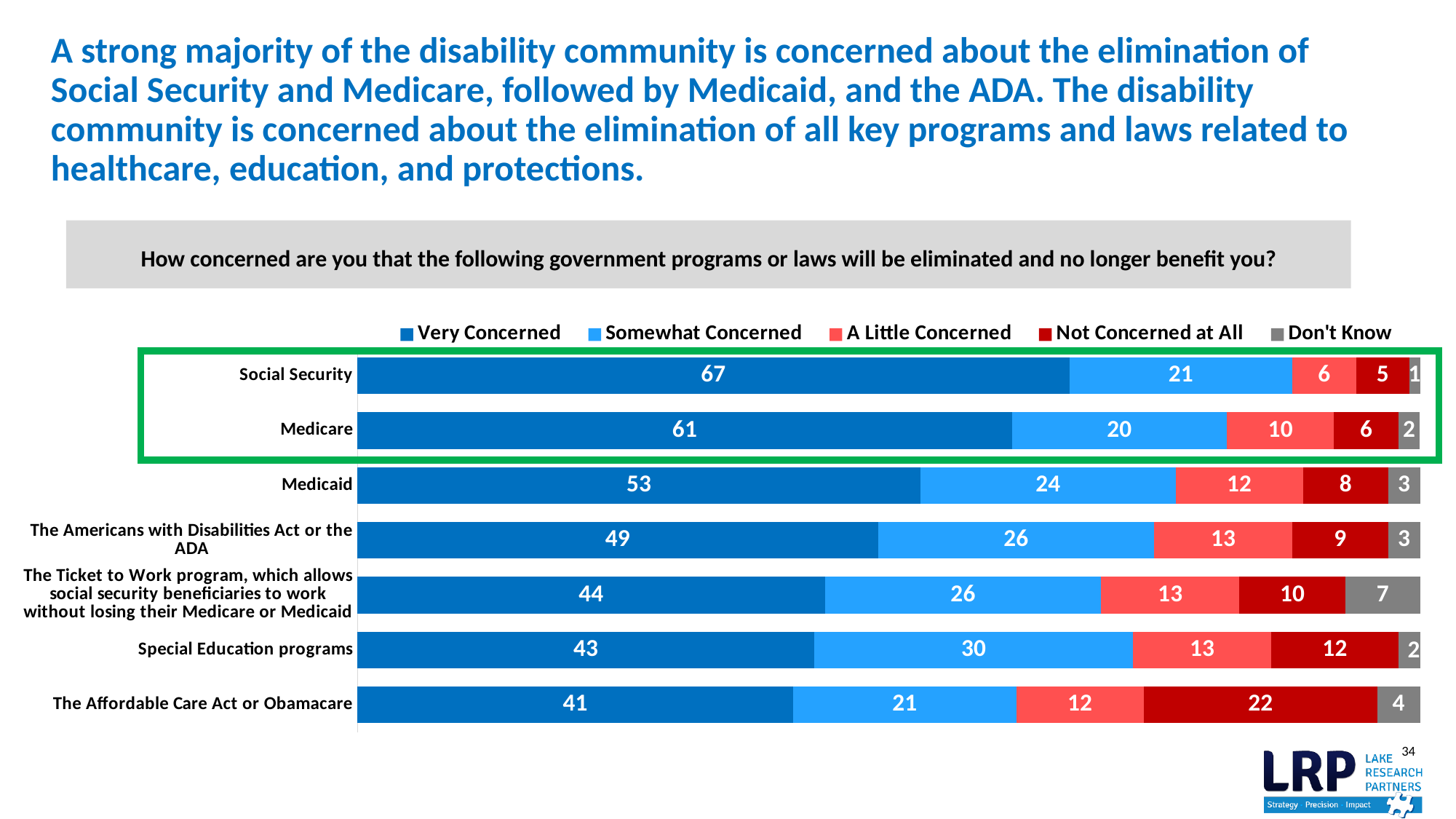
What is the 'Not Concerned at All' value for The Affordable Care Act or Obamacare? 22 What is the 'Very Concerned' value for Social Security? 67 What is the difference between the 'Very Concerned' values for Social Security and Medicare? 6 What is the 'Don't Know' value for The Ticket to Work program? 7 What is the 'Somewhat Concerned' value for Special Education programs? 30 What is the total of the stacked bar for Medicaid? 100 How many programs or laws are shown in the chart? 7 Which program has the lowest 'Very Concerned' value? The Affordable Care Act or Obamacare Which program has the highest 'Very Concerned' value? Social Security How many series does the legend list? 5 Which has a larger 'Not Concerned at All' value, Medicaid or Special Education programs? Special Education programs What kind of chart is shown on the slide? Stacked bar chart